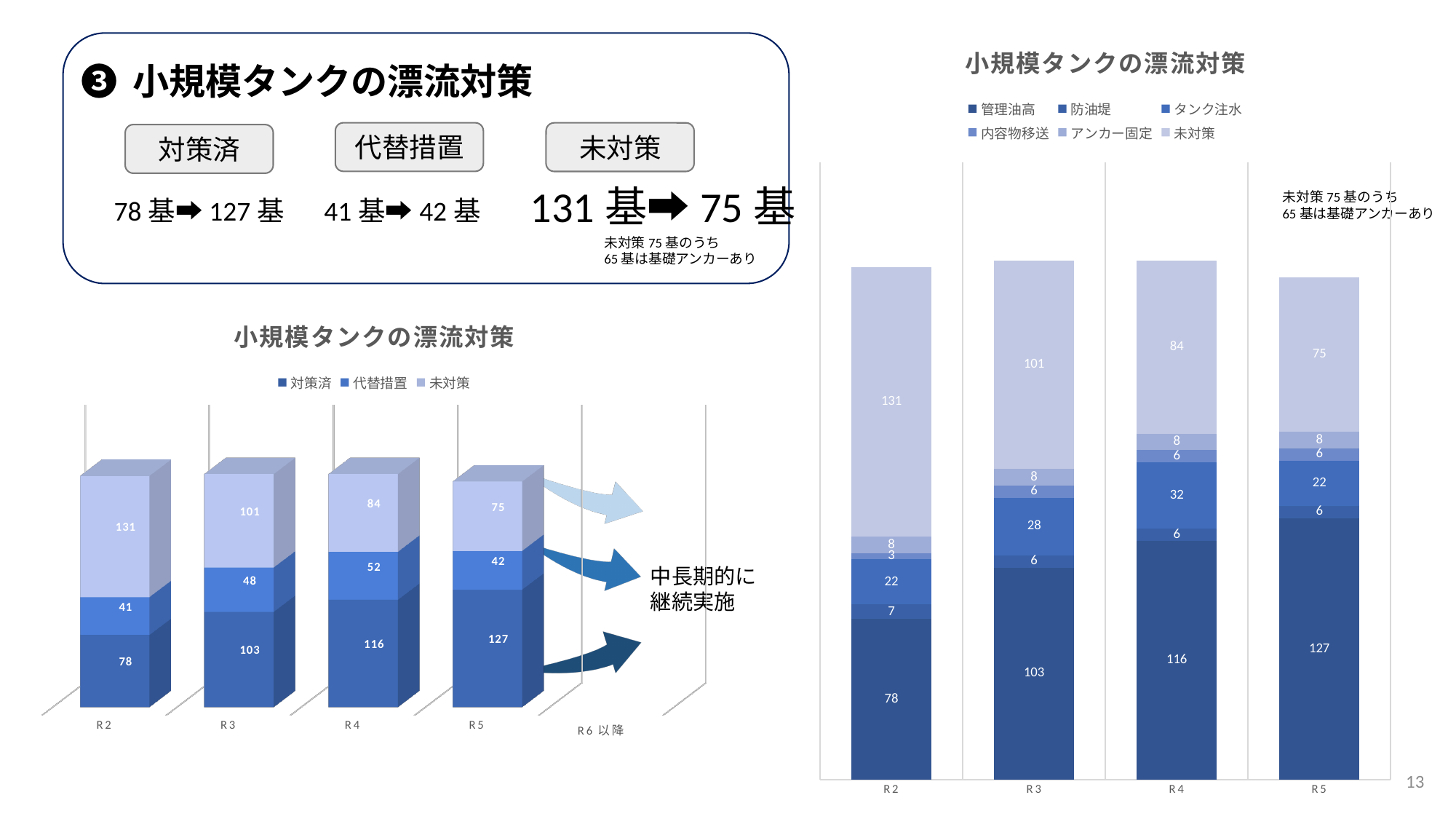
In the left chart, which year has the lowest 対策済 value? R2 In the left chart, what is the value of 対策済 for R5? 127 In the left chart, which year has the highest 未対策 value? R2 In the left chart, what is the difference between the 対策済 values for R5 and R2? 49 In the left chart, what is the total of the stacked bar for R5? 244 In the left chart, does the 対策済 value rise or fall from R2 to R5? rise What kind of chart is the right chart? stacked bar chart In the right chart, what is the value of 防油堤 for R2? 7 In the right chart, what is the value of タンク注水 for R4? 32 In the right chart, which is larger: 未対策 for R3 or 未対策 for R5? 未対策 for R3 How many series does the legend of the right chart list? 6 In the left chart, what is the value of 未対策 for R2? 131